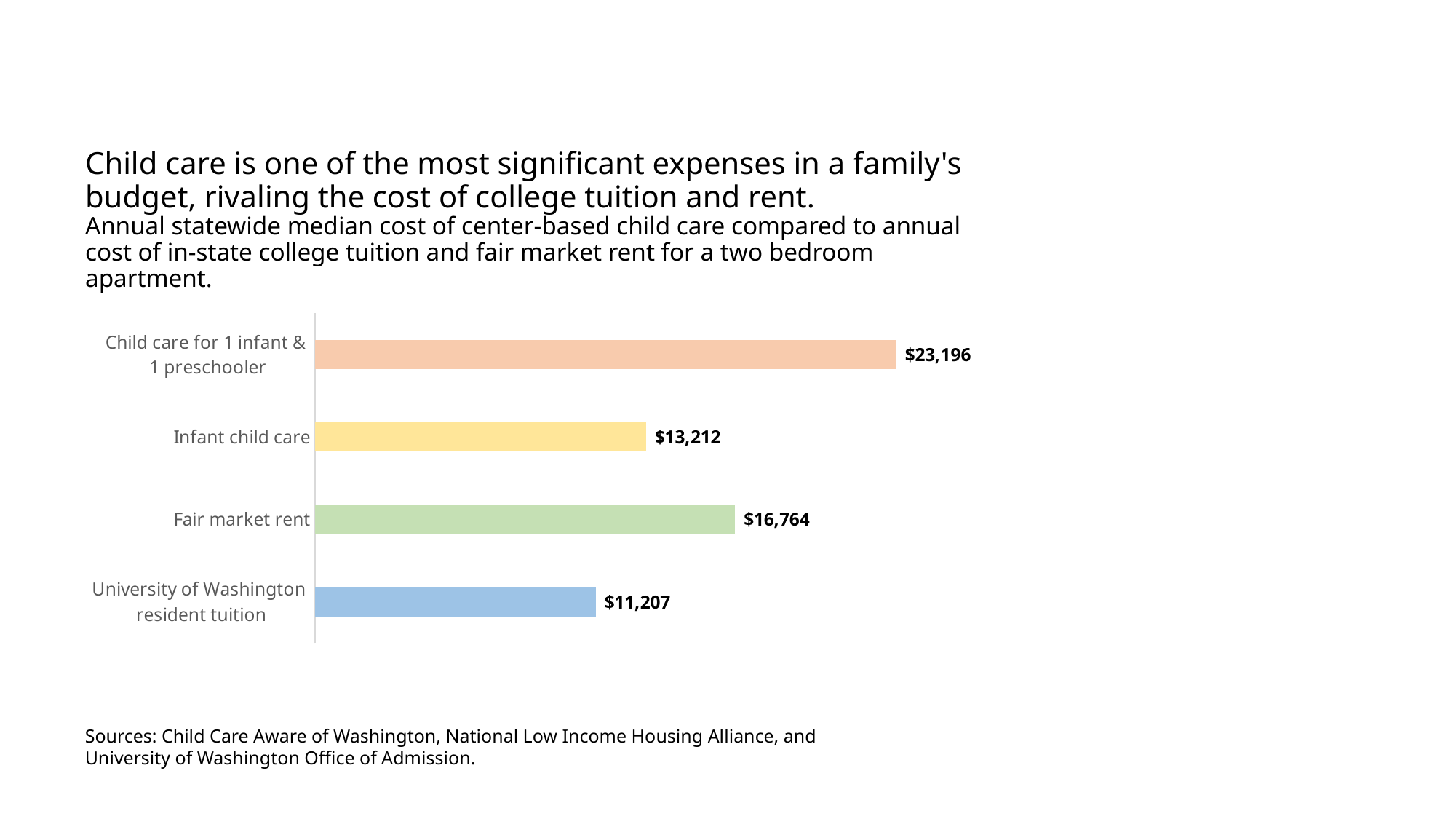
What is the difference between the cost of child care for 1 infant & 1 preschooler and University of Washington resident tuition? $11,989 What is the annual cost of child care for 1 infant & 1 preschooler? $23,196 Which category has the highest annual cost? Child care for 1 infant & 1 preschooler What type of chart is shown on the slide? Bar chart How many categories are shown on the chart? 4 Which category has the lowest annual cost? University of Washington resident tuition What is the annual University of Washington resident tuition? $11,207 What is the difference between fair market rent and infant child care? $3,552 Which is larger, infant child care or University of Washington resident tuition? Infant child care Which is larger, infant child care or fair market rent? Fair market rent What is the annual cost of infant child care? $13,212 What is the annual fair market rent shown on the chart? $16,764